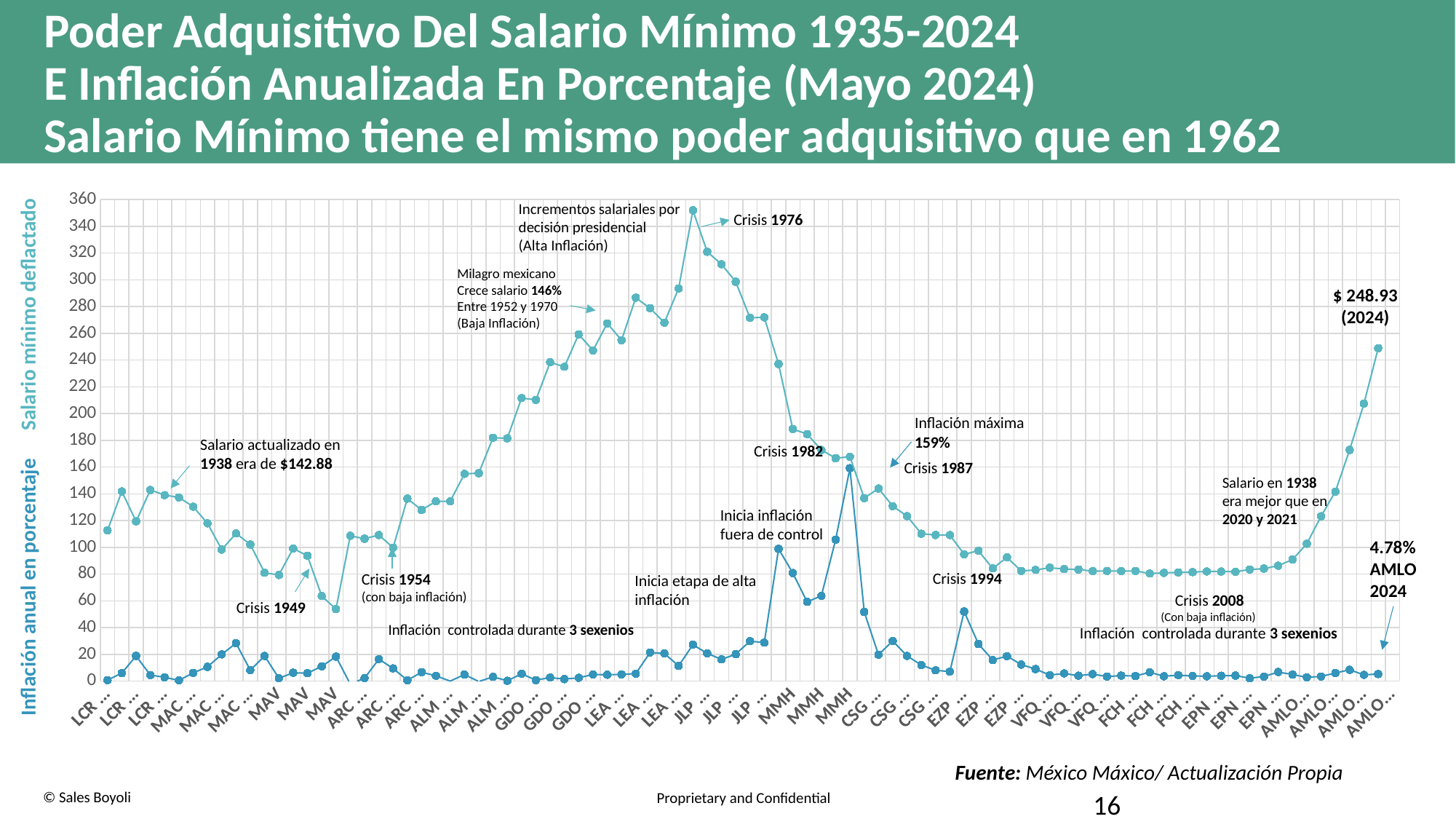
In which year does the deflated minimum wage series reach its highest point? 1976 What does the light teal series on the chart represent? Salario mínimo deflactado What annual inflation percentage is shown for AMLO 2024? 4.78% According to the annotation, what was the updated minimum wage in 1938? $142.88 Does the deflated minimum wage rise or fall between the 1976 peak and the 1982 crisis? fall What kind of chart is shown on the slide? line chart Is the deflated minimum wage during the VFQ and FCH periods greater or less than 100? less What is the deflated minimum wage value shown for 2024? $ 248.93 What is the difference between the deflated minimum wage in 2024 ($ 248.93) and in 1938 ($142.88)? $106.05 What is the maximum inflation value annotated on the chart (Crisis 1987)? 159% How many data series are plotted on the chart? 2 Is the deflated minimum wage at its 1976 peak greater or less than 340? greater